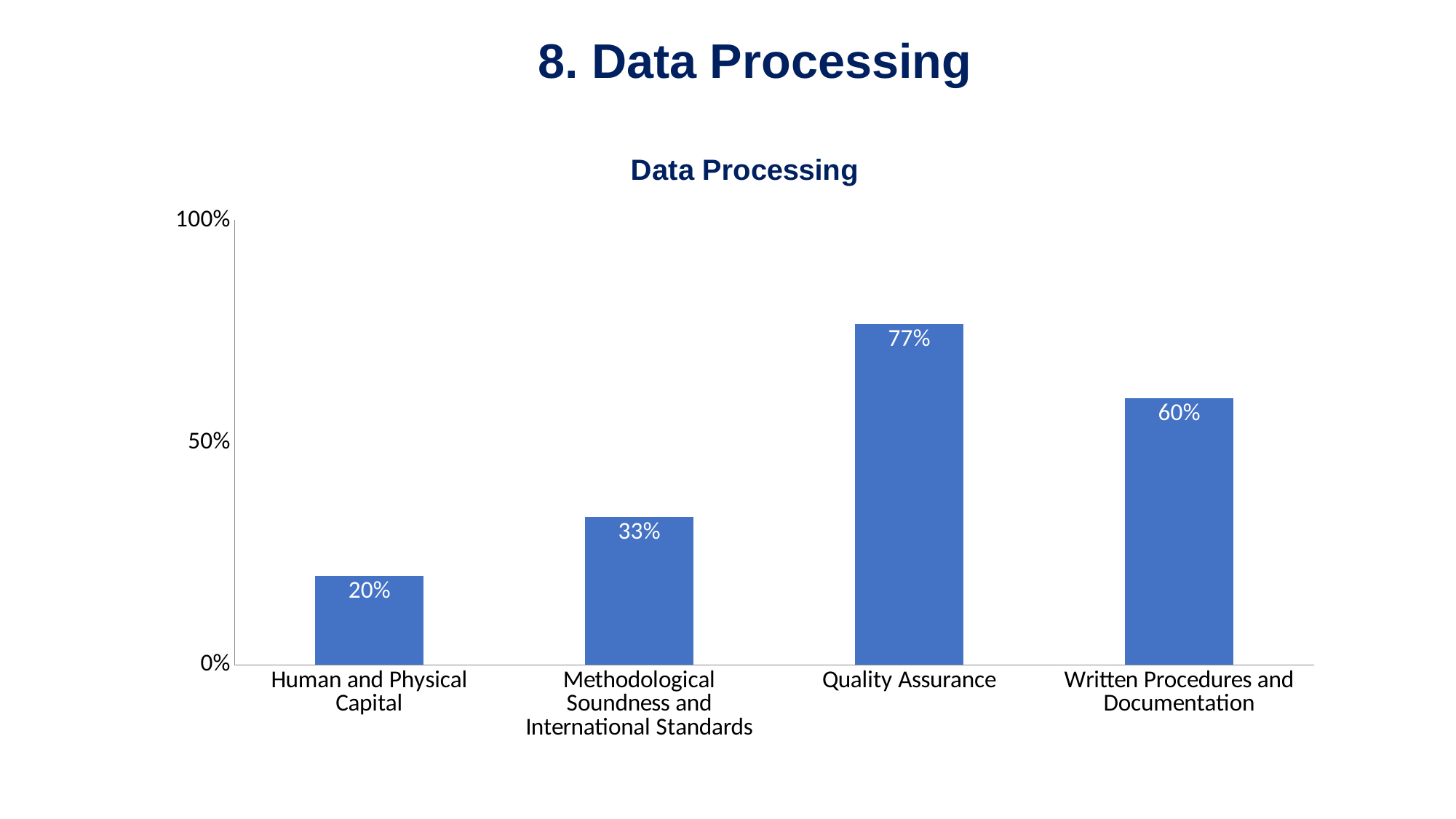
How many categories are shown in the chart? 4 Which category has the lowest value? Human and Physical Capital What is the value for Quality Assurance? 77% Which category has the highest value? Quality Assurance What is the difference between the values for Quality Assurance and Written Procedures and Documentation? 17% What is the value for Written Procedures and Documentation? 60% Which is larger, the value for Methodological Soundness and International Standards or the value for Written Procedures and Documentation? Written Procedures and Documentation What is the title of the chart? Data Processing What kind of chart is shown on the slide? Bar chart Is the value for Quality Assurance greater or less than 50%? greater What is the value for Human and Physical Capital? 20% What is the value for Methodological Soundness and International Standards? 33%